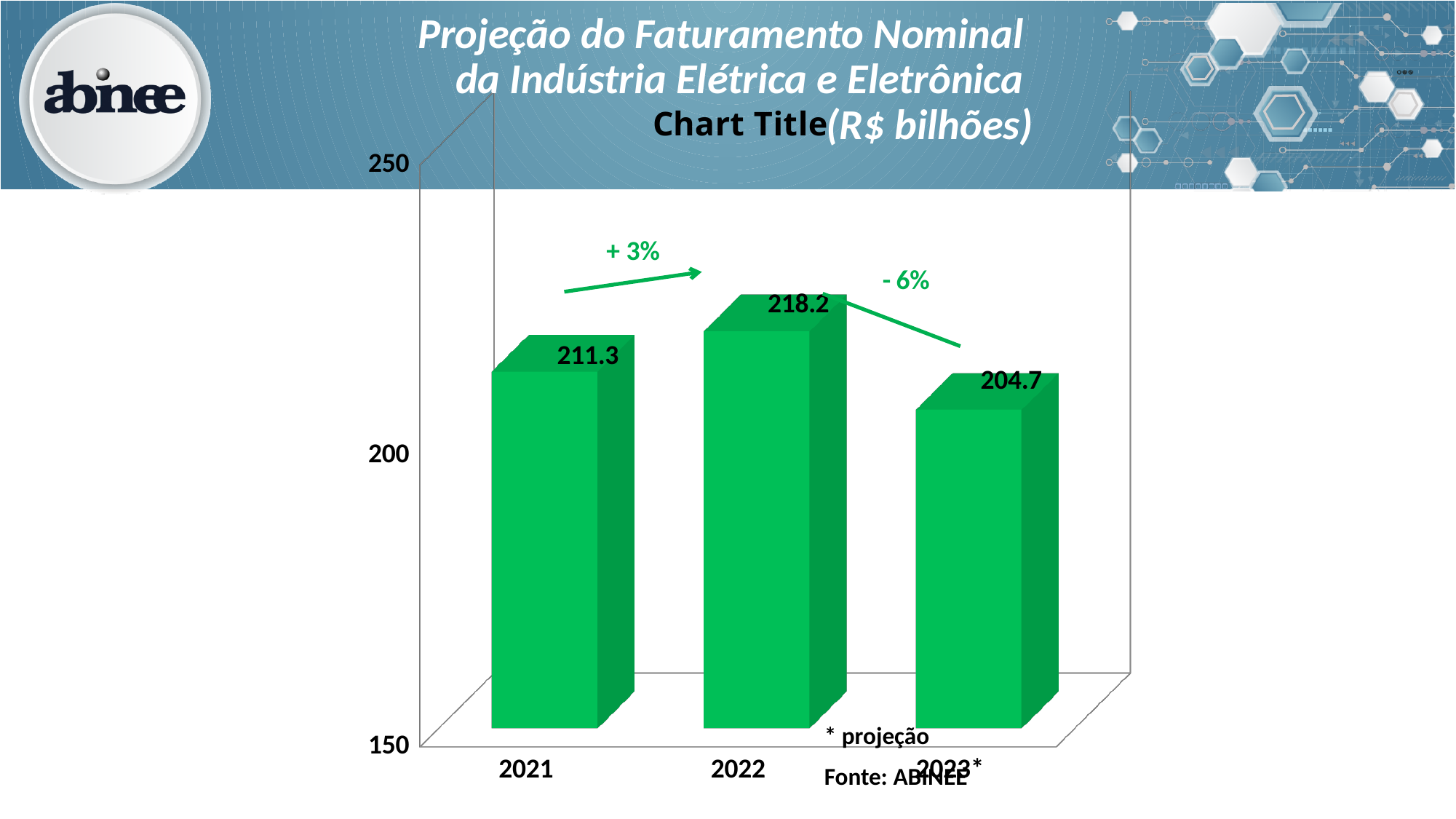
Which year has the lowest value? 2023* How many years are shown on the chart? 3 What kind of chart is shown on the slide? bar chart What is the value for 2021? 211.3 What is the difference between the values for 2022 and 2023*? 13.5 Which year has the highest value? 2022 What is the value for 2023*? 204.7 What is the difference between the values for 2022 and 2021? 6.9 What is the value for 2022? 218.2 Is the value for 2023* greater or less than 200? greater Which is larger, the value for 2021 or the value for 2023*? 2021 What percentage change is annotated between 2022 and 2023*? - 6%